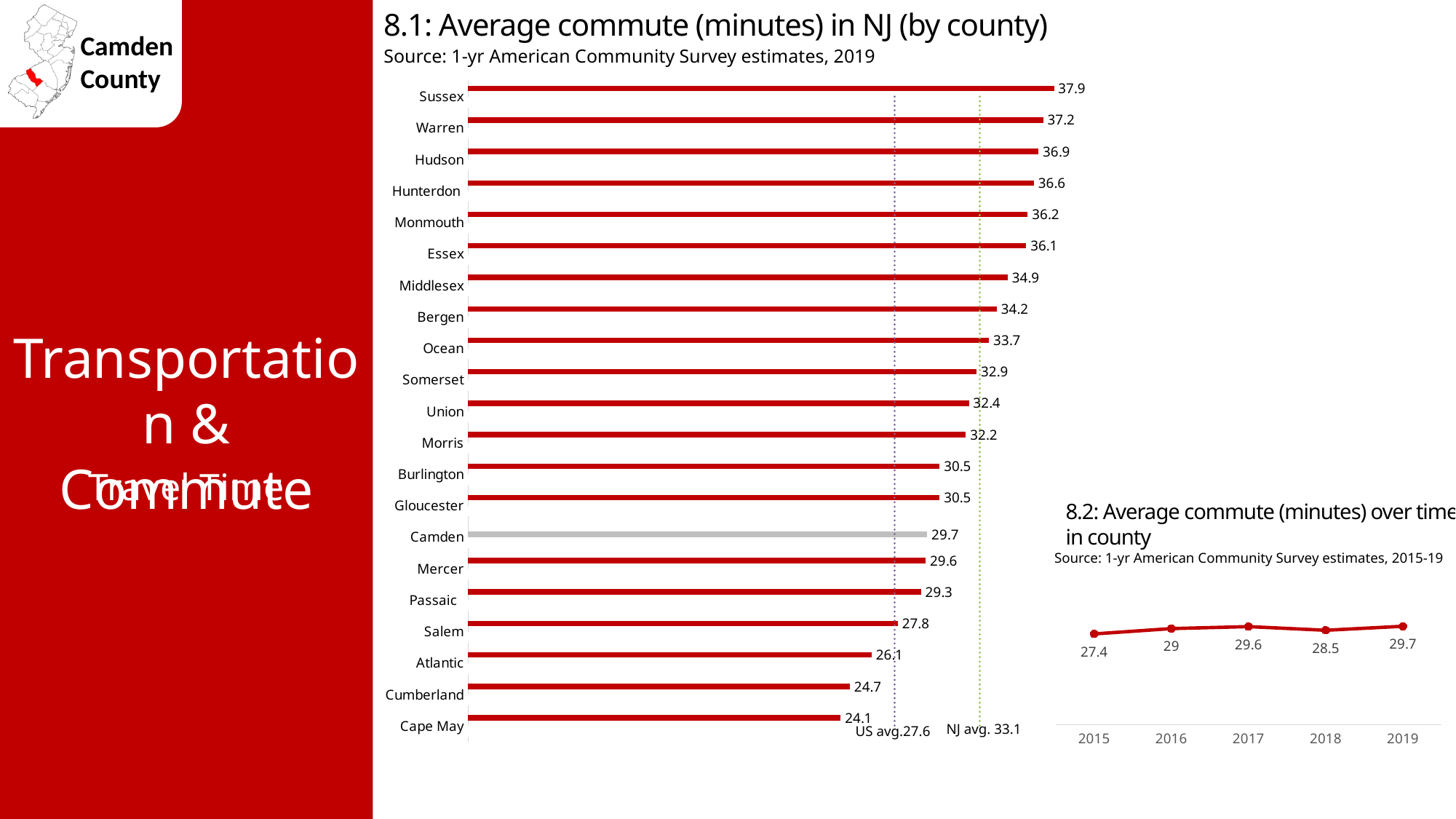
In chart 8.1 (Average commute in NJ by county), what is the average commute for Atlantic? 26.1 In chart 8.1 (Average commute in NJ by county), which has a longer average commute, Hudson or Mercer? Hudson In chart 8.2 (Average commute over time in county), what is the value for 2018? 28.5 In chart 8.1 (Average commute in NJ by county), which county has the highest average commute? Sussex In chart 8.1 (Average commute in NJ by county), what NJ average value is marked by the dotted line? 33.1 In chart 8.1 (Average commute in NJ by county), what is the average commute for Camden? 29.7 In chart 8.2 (Average commute over time in county), how many data points are plotted? 5 In chart 8.1 (Average commute in NJ by county), which county has the lowest average commute? Cape May In chart 8.2 (Average commute over time in county), which year has the lowest value? 2015 In chart 8.1 (Average commute in NJ by county), how many counties are shown? 21 What kind of chart is chart 8.2 (Average commute over time in county)? line chart In chart 8.1 (Average commute in NJ by county), what is the difference between the values for Sussex and Cape May? 13.8